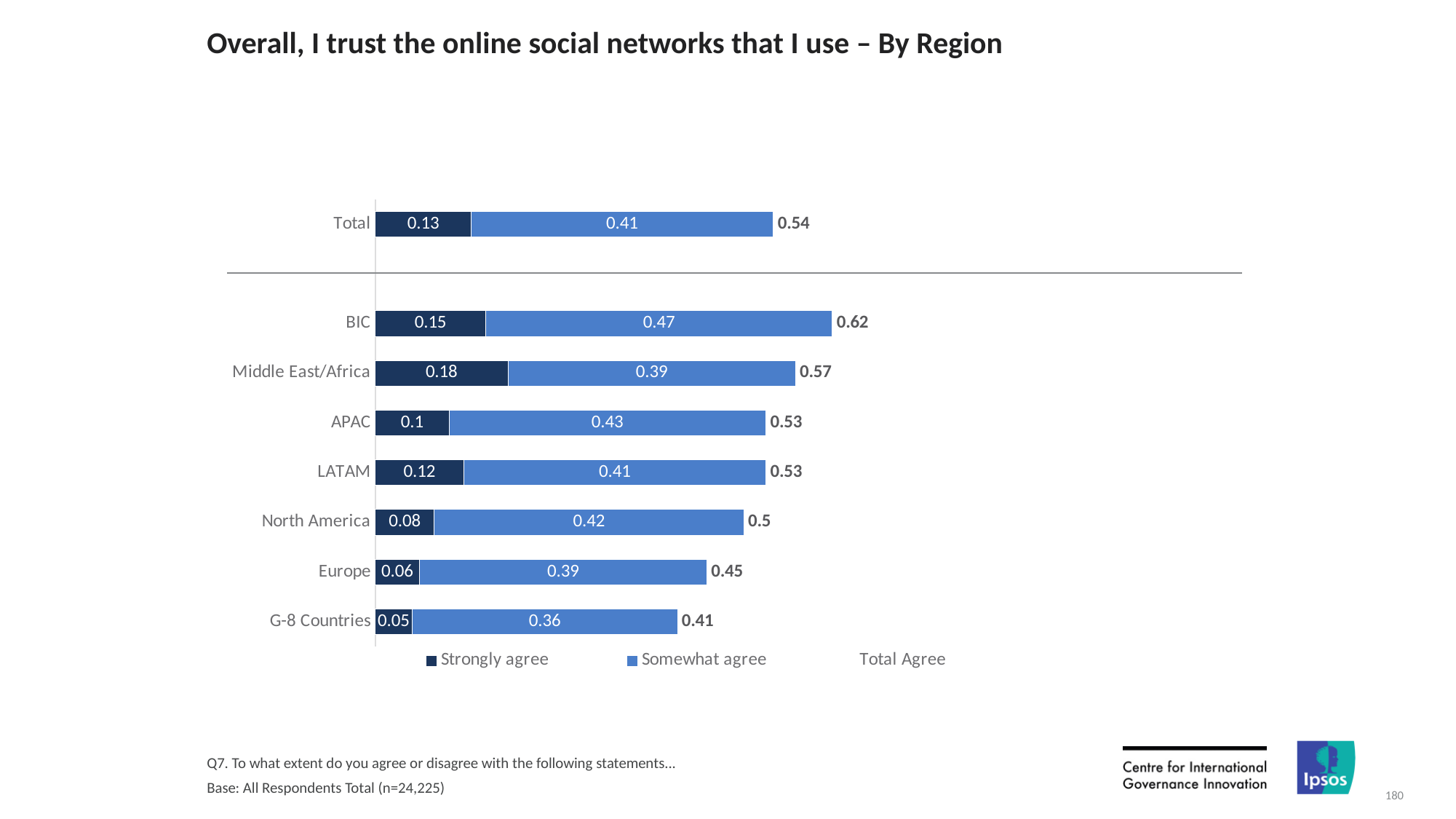
Which region has the highest Total Agree value? BIC How many series does the legend list? 3 What is the Somewhat agree value for BIC? 0.47 What is the Strongly agree value for Middle East/Africa? 0.18 What is the Total Agree value for Europe? 0.45 What is the total of the stacked bar for LATAM? 0.53 Which is larger, the Somewhat agree value for APAC or for North America? APAC How many regions are shown below the Total bar? 7 Which region has the lowest Strongly agree value? G-8 Countries What is the difference between the Total Agree values for BIC and G-8 Countries? 0.21 What is the title of the chart? Overall, I trust the online social networks that I use – By Region What kind of chart is shown on the slide? Stacked bar chart